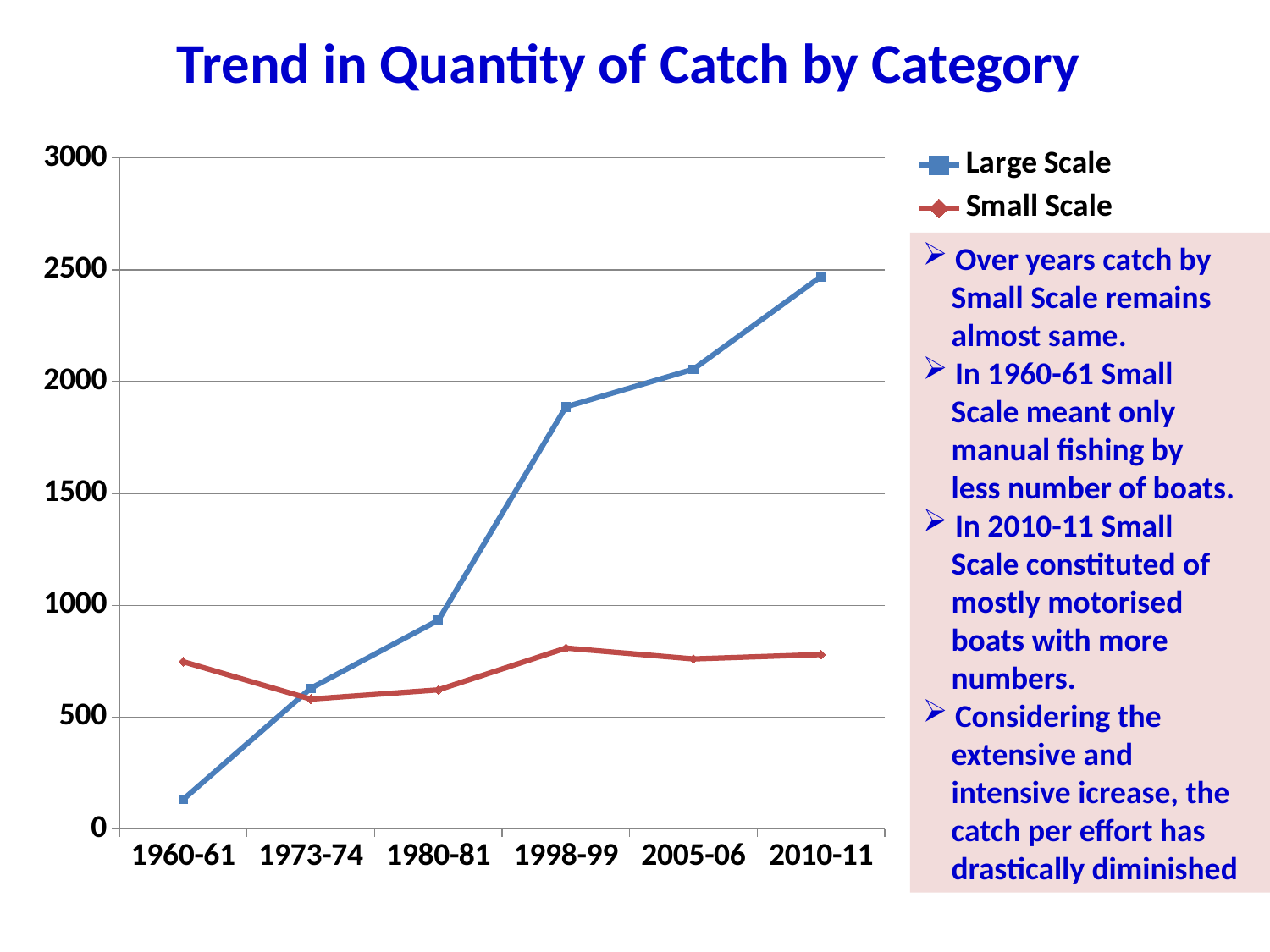
Is the Small Scale value for 1998-99 greater or less than 1000? less Does the Large Scale catch rise or fall from 1960-61 to 2010-11? rise What is the title of the chart? Trend in Quantity of Catch by Category In which period is the Large Scale catch lowest? 1960-61 In 1960-61, which series has the larger catch, Large Scale or Small Scale? Small Scale Is the Large Scale value for 1960-61 greater or less than 500? less Is the Large Scale value for 2010-11 greater or less than 2000? greater How many time periods are shown on the x axis? 6 How many series does the legend list? 2 In which period is the Large Scale catch highest? 2010-11 What kind of chart is shown on the slide? line chart In 2010-11, which series has the larger catch, Large Scale or Small Scale? Large Scale